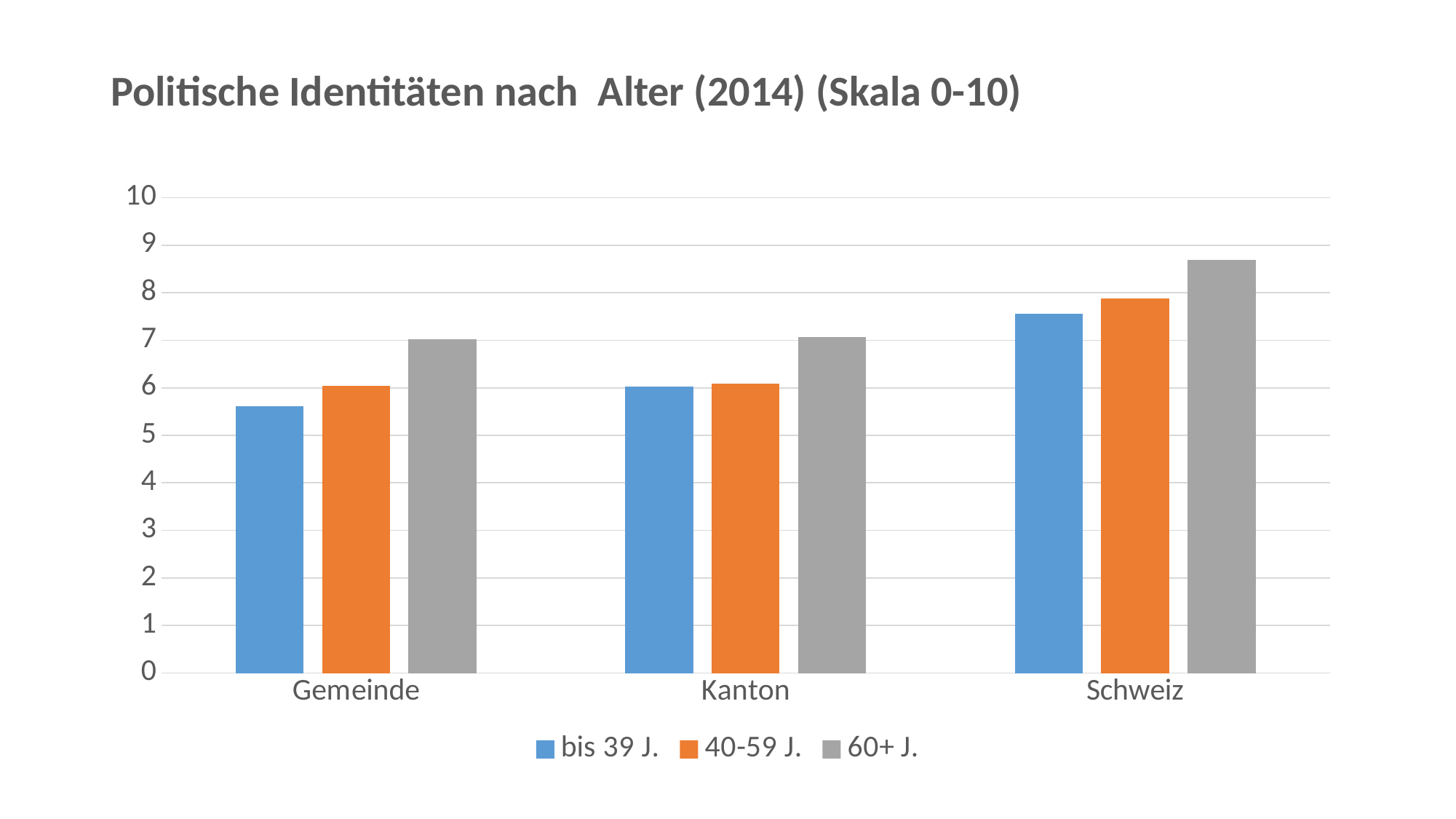
What is the title of the chart? Politische Identitäten nach Alter (2014) (Skala 0-10) Which category has the highest value for the 60+ J. series? Schweiz What kind of chart is shown on the slide? bar chart How many series does the legend list? 3 Is the value for 60+ J. in Kanton greater or less than 6? greater Which series has the lowest value in the Gemeinde category? bis 39 J. Is the value for bis 39 J. in Gemeinde greater or less than 6? less In Gemeinde, which is larger: the value for 60+ J. or the value for bis 39 J.? 60+ J. Is the value for 60+ J. in Schweiz greater or less than 8? greater How many categories are shown on the x axis? 3 Do the values for the bis 39 J. series rise or fall from Gemeinde to Schweiz? rise